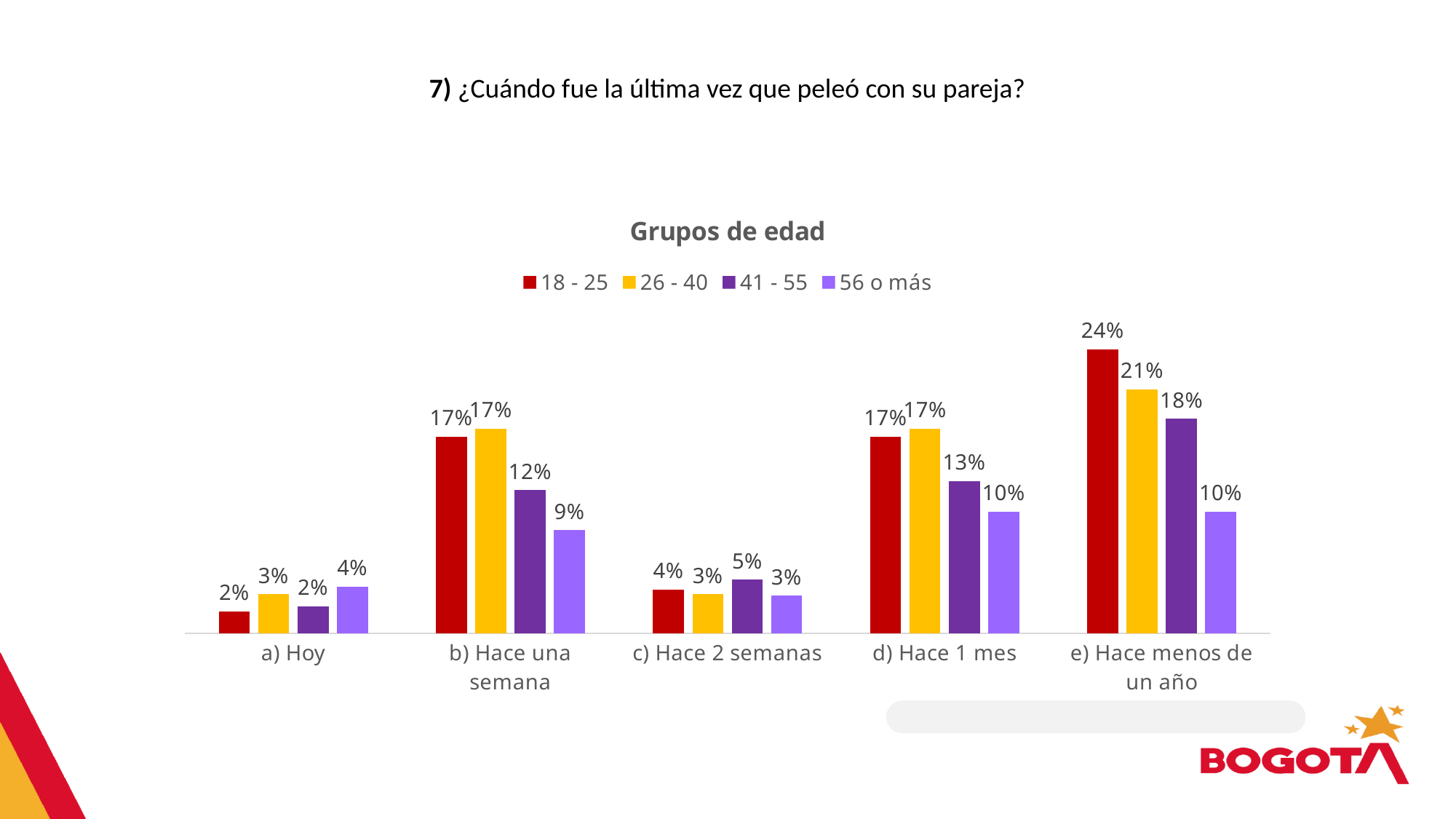
What is the value for the 56 o más series in the category 'd) Hace 1 mes'? 10% What is the value for the 41 - 55 series in the category 'b) Hace una semana'? 12% In the category 'c) Hace 2 semanas', which is larger: the 41 - 55 value or the 26 - 40 value? 41 - 55 Which category has the highest value for the 18 - 25 series? e) Hace menos de un año How many series does the legend list? 4 How many categories are shown on the x axis? 5 What is the difference between the 18 - 25 value and the 56 o más value in the category 'e) Hace menos de un año'? 14% What is the value for the 18 - 25 series in the category 'e) Hace menos de un año'? 24% What kind of chart is shown on the slide? Bar chart What is the value for the 26 - 40 series in the category 'a) Hoy'? 3% What is the title of the chart? Grupos de edad